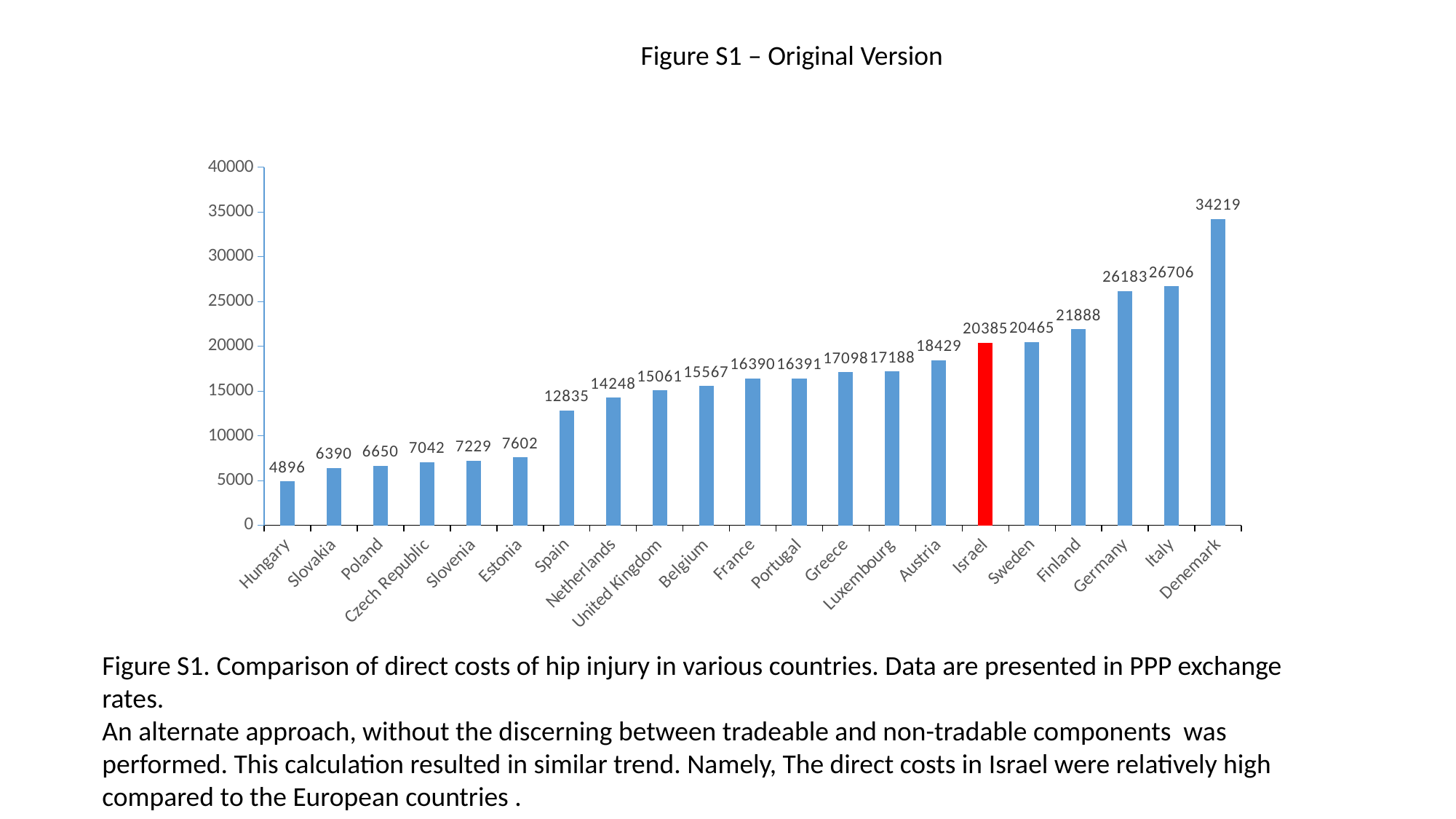
What is the value shown for United Kingdom? 15061 Which country has the highest value? Denmark What kind of chart is shown? Bar chart What is the difference between the values for Israel and Austria? 1956 Which country has the lowest value? Hungary What is the value shown for Hungary? 4896 What is the difference between the values for Denmark and Italy? 7513 How many countries are shown on the x axis? 21 What is the value shown for Israel? 20385 Which country's bar is coloured red? Israel Which has a larger value, Germany or Sweden? Germany Is the value for Spain greater or less than 10000? greater